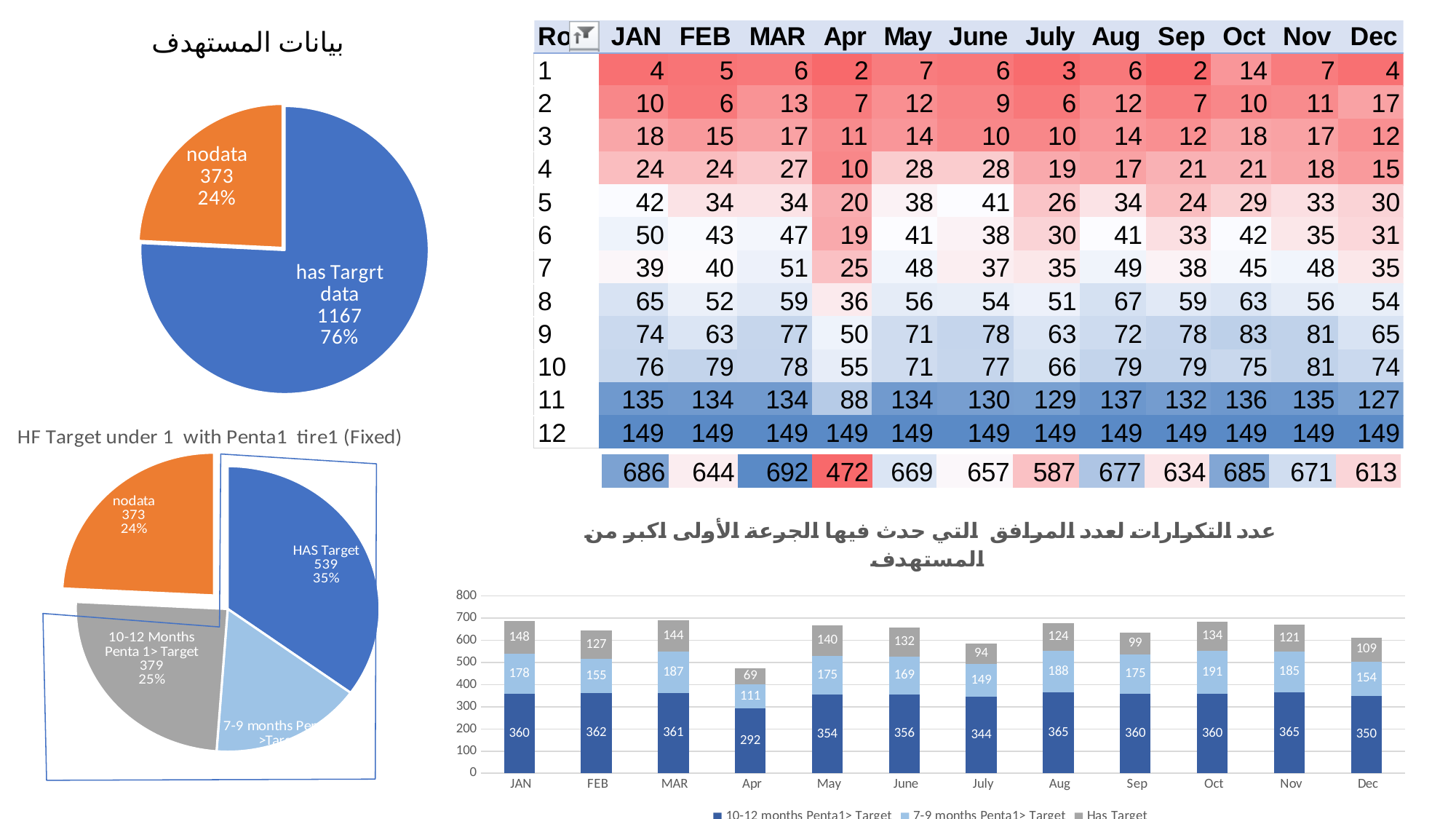
In the bottom-right stacked bar chart, what is the value of the '10-12 months Penta1> Target' series for Apr? 292 In the bottom-left pie chart 'HF Target under 1 with Penta1 tire1 (Fixed)', what percentage is shown for the '10-12 Months Penta 1> Target' slice? 25% In the bottom-right stacked bar chart, what is the value of the 'Has Target' series for MAR? 144 In the top-left pie chart titled 'بيانات المستهدف', how many slices are there? 2 In the top-left pie chart titled 'بيانات المستهدف', what percentage share does the 'has Targrt data' slice have? 76% What kind of chart is the bottom-right chart? Stacked bar chart In the top-left pie chart titled 'بيانات المستهدف', what value is shown for the 'nodata' slice? 373 In the bottom-left pie chart 'HF Target under 1 with Penta1 tire1 (Fixed)', what value is shown for the 'HAS Target' slice? 539 In the bottom-right stacked bar chart, what is the value of the '7-9 months Penta1> Target' series for Oct? 191 In the bottom-right stacked bar chart, which month has the lowest value for the '10-12 months Penta1> Target' series? Apr In the bottom-right stacked bar chart, how many series does the legend list? 3 In the bottom-right stacked bar chart, what is the difference between the 'Has Target' values for JAN and Apr? 79